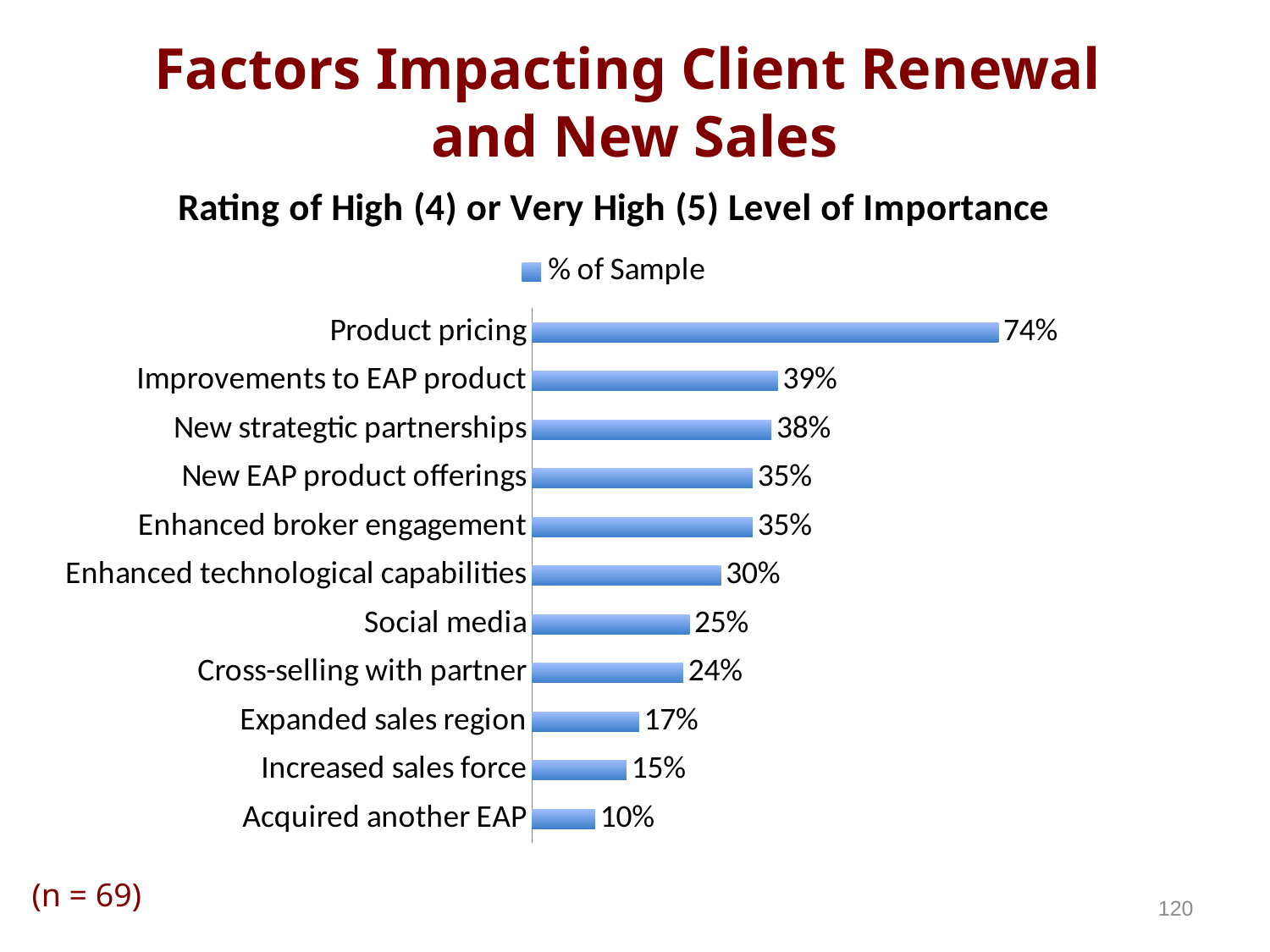
Which category has the highest value? Product pricing What is the difference between the values for Product pricing and Improvements to EAP product? 35% What is the value for Acquired another EAP? 10% What is the difference between the values for Social media and Increased sales force? 10% How many categories are shown in the chart? 11 How many series does the legend list? 1 What is the value for Enhanced technological capabilities? 30% Which is larger, the value for New strategtic partnerships or the value for Cross-selling with partner? New strategtic partnerships Which category has the lowest value? Acquired another EAP What is the value for Product pricing? 74% What is the legend entry for the series shown in the chart? % of Sample What kind of chart is shown on the slide? Bar chart